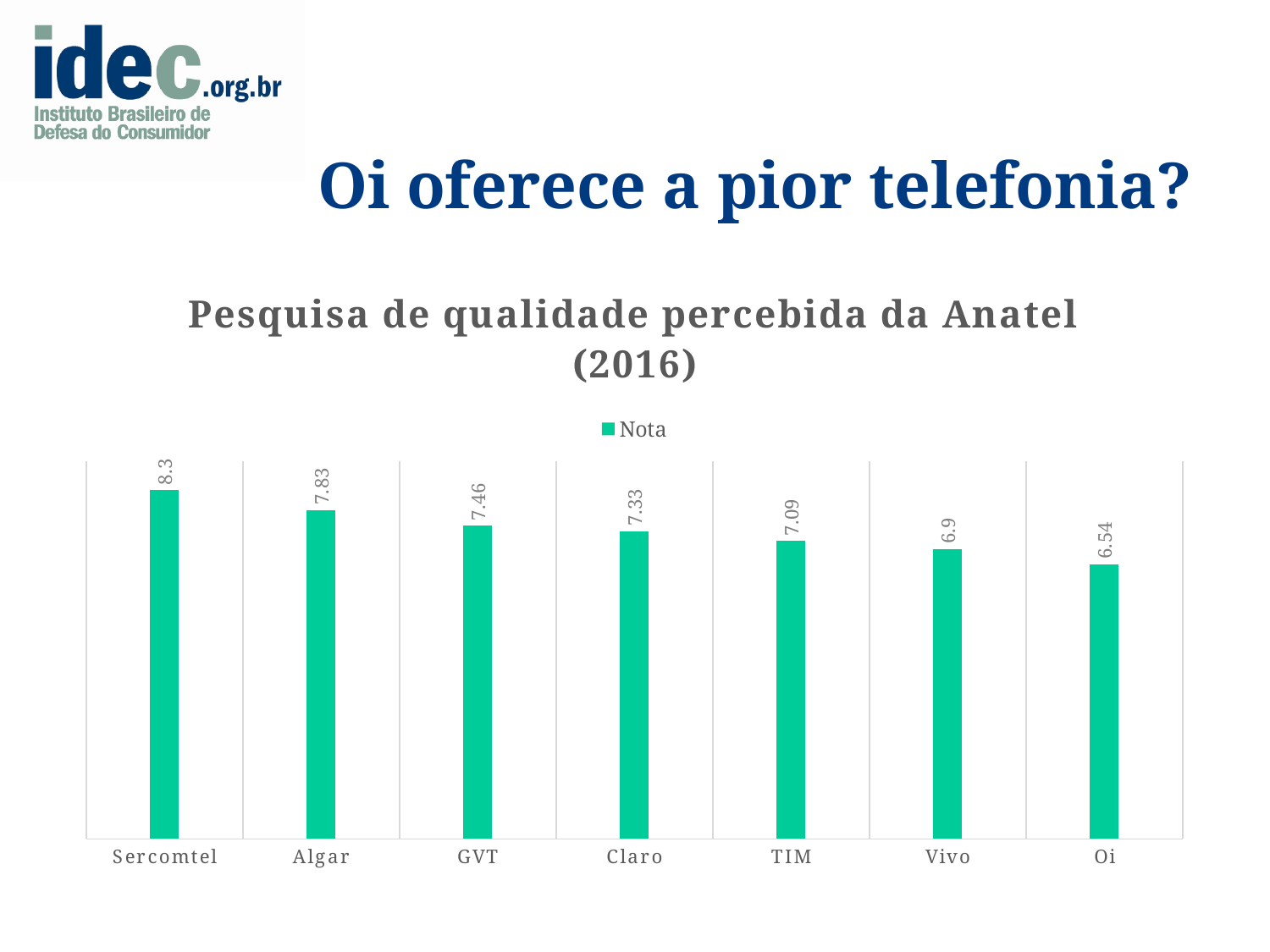
What kind of chart is shown on the slide? Bar chart How many operators are shown in the chart? 7 What is the difference between the Nota for Algar and the Nota for GVT? 0.37 How many series does the legend list? 1 What is the difference between the Nota for Sercomtel and the Nota for Oi? 1.76 Do the Nota values rise or fall from left to right across the operators? Fall What is the Nota value for Sercomtel? 8.3 Which operator has the lowest Nota? Oi Which operator has the highest Nota? Sercomtel What is the Nota value for Claro? 7.33 What is the Nota value for Oi? 6.54 Which has a higher Nota, TIM or Vivo? TIM